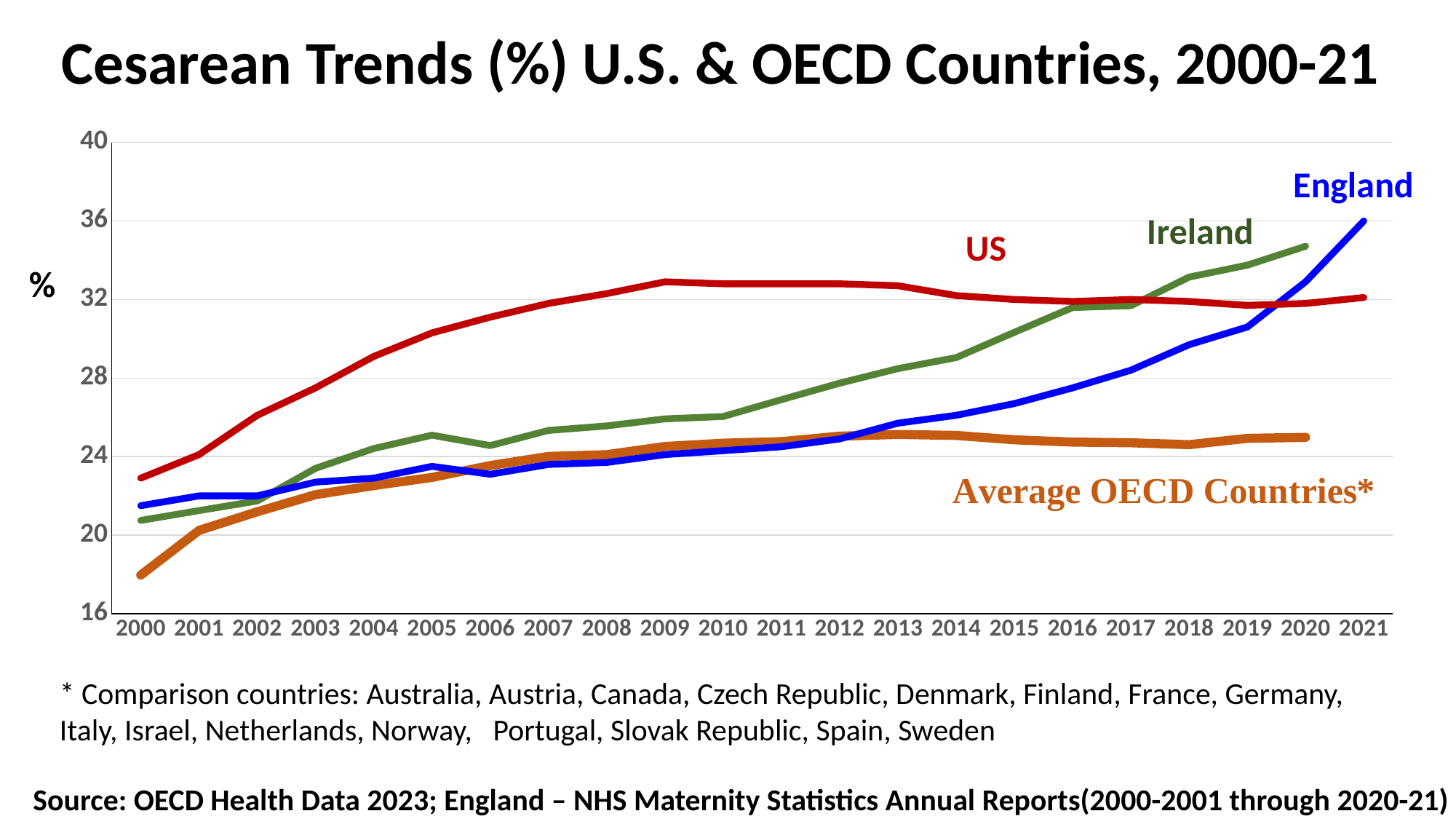
Which series has the lowest value in 2000? Average OECD Countries Is the value for Average OECD Countries in 2000 greater or less than 20? less In 2010, which is larger: the value for the US or the value for Ireland? US How many series (lines) are plotted on the chart? 4 Which series has the lowest value in 2020? Average OECD Countries What is the title of the chart? Cesarean Trends (%) U.S. & OECD Countries, 2000-21 What kind of chart is shown on the slide? Line chart Which series has the highest value in 2021? England Is the value for England in 2021 greater or less than 32? greater Does the England line generally rise or fall from 2000 to 2021? rise How many years are shown along the x axis of the chart? 22 In 2021, which is larger: the value for England or the value for the US? England